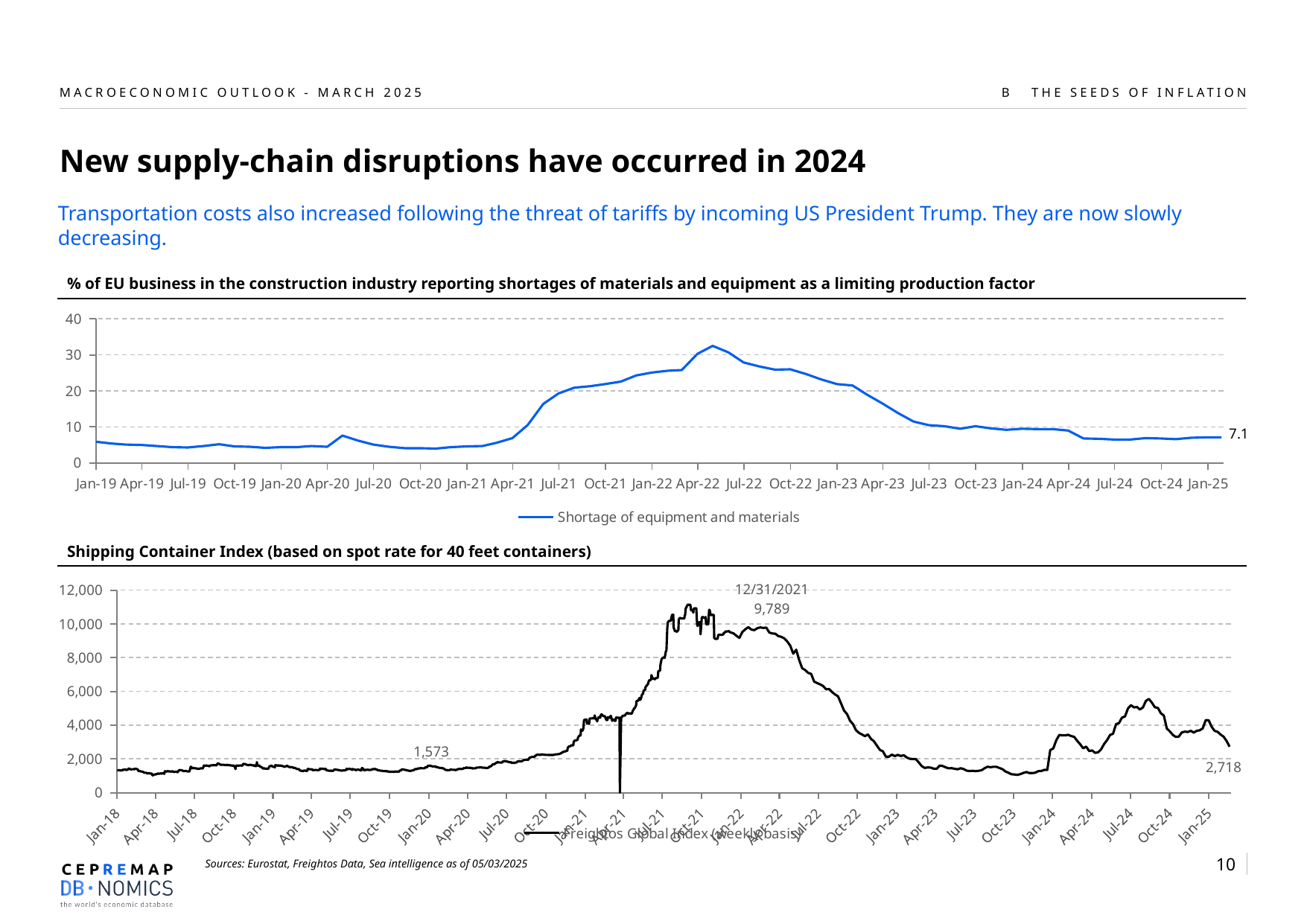
How many series does the legend of the top chart on shortages of materials and equipment list? 1 In the bottom chart, Shipping Container Index, what is the last value labelled at the end of the series? 2,718 In the bottom chart, Shipping Container Index, what is the difference between the value labelled at 12/31/2021 and the final labelled value of 2,718? 7,071 In the bottom chart, Shipping Container Index, which labelled value is larger: 1,573 or 2,718? 2,718 In the top chart on shortages of materials and equipment, is the value at Jan-22 greater or less than 20? greater In the top chart on shortages of materials and equipment, do the values rise or fall from Jul-22 to Jan-25? Fall What kind of chart is the top chart, '% of EU business in the construction industry reporting shortages of materials and equipment as a limiting production factor'? Line chart What is the legend entry of the top chart on shortages of materials and equipment? Shortage of equipment and materials In the bottom chart, Shipping Container Index, is the value around Jul-24 greater or less than 4,000? greater In the bottom chart, Shipping Container Index, what value is labelled at 12/31/2021? 9,789 In the top chart on shortages of materials and equipment, what is the value shown at the end of the series (Jan-25)? 7.1